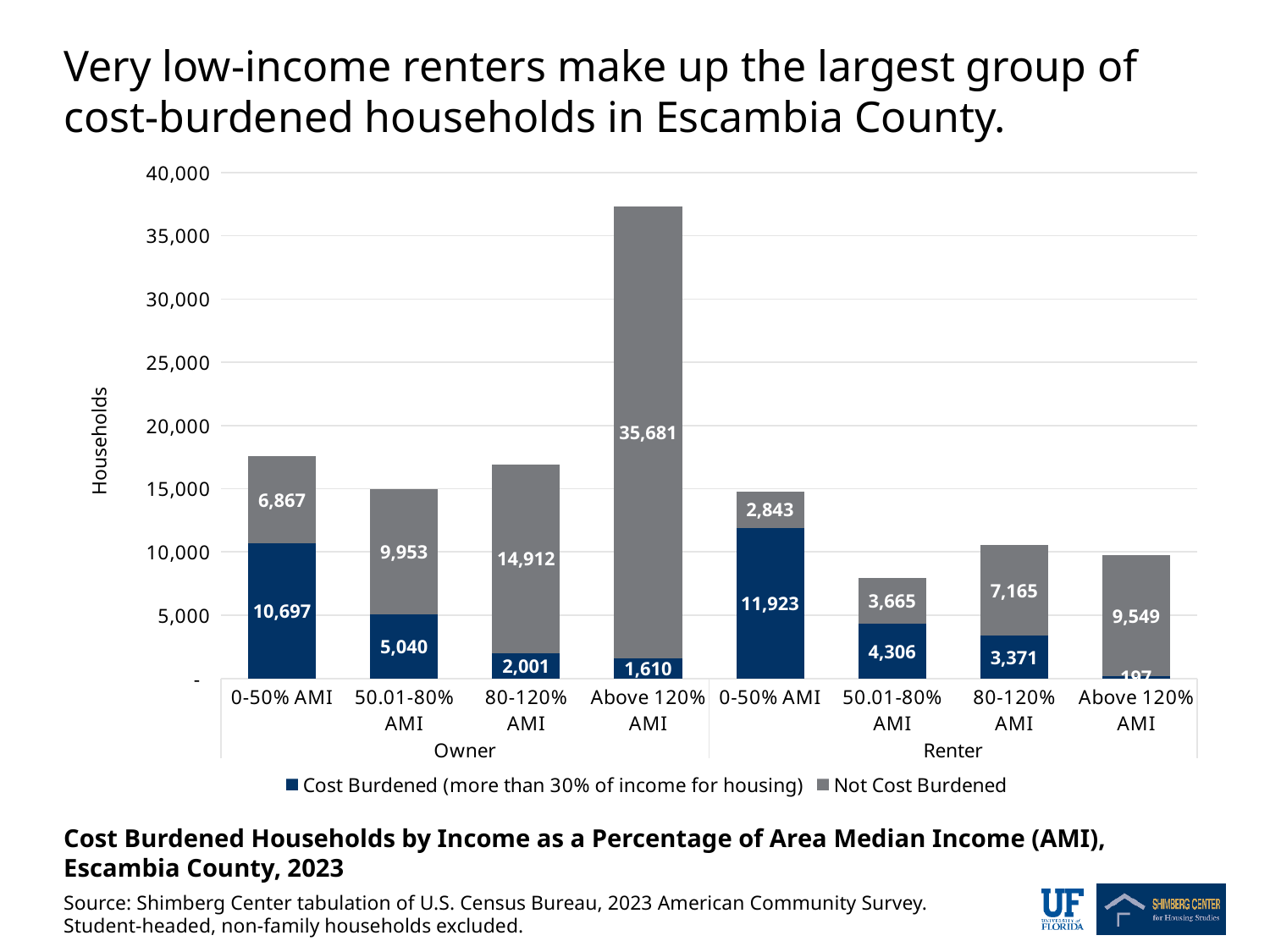
Among owner groups, which income group has the fewest cost-burdened households? Above 120% AMI How many series does the legend list? 2 How many cost-burdened owner households are in the 0-50% AMI group? 10,697 What is the total number of owner households in the 0-50% AMI group (cost burdened plus not cost burdened)? 17,564 Which tenure and income group has the largest number of cost-burdened households? Renter, 0-50% AMI Is the total height of the Owner Above 120% AMI bar greater or less than 35,000? greater How many not-cost-burdened renter households are in the 80-120% AMI group? 7,165 What kind of chart is shown on the slide? Stacked bar chart What is the total number of renter households in the 50.01-80% AMI group? 7,971 How many more cost-burdened households are there among 0-50% AMI renters than among 0-50% AMI owners? 1,226 Which tenure and income group has the largest number of not-cost-burdened households? Owner, Above 120% AMI In the 50.01-80% AMI group, are there more cost-burdened households among owners or renters? Owners